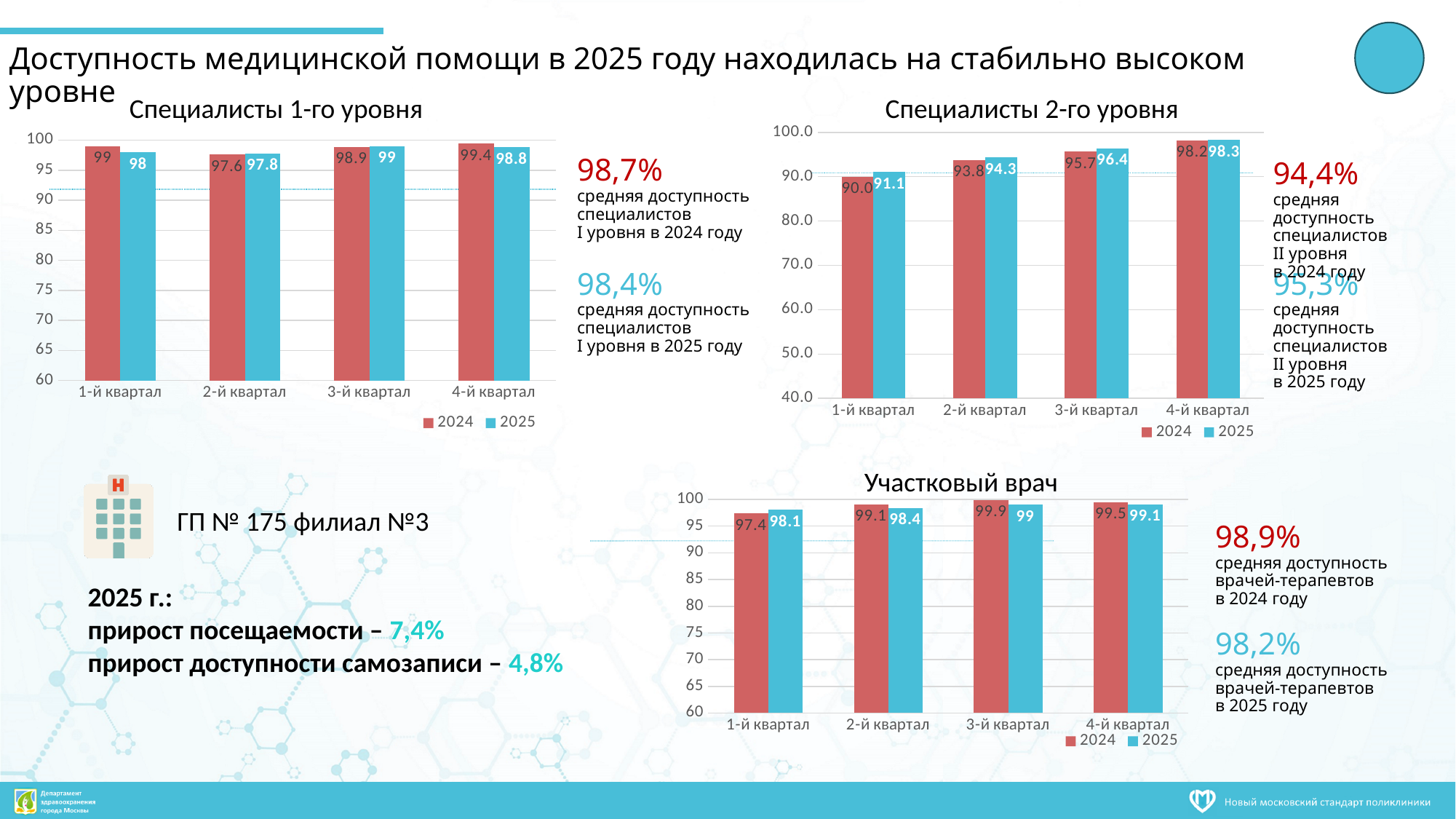
In the chart titled 'Специалисты 1-го уровня', what is the value for 2024 in 2-й квартал? 97.6 What kind of chart is the chart titled 'Специалисты 1-го уровня'? bar chart In the chart titled 'Специалисты 2-го уровня', do the 2024 values rise or fall from 1-й квартал to 4-й квартал? rise In the chart titled 'Специалисты 2-го уровня', which quarter has the lowest value for 2024? 1-й квартал In the chart titled 'Участковый врач', what is the value for 2024 in 3-й квартал? 99.9 In the chart titled 'Участковый врач', which is larger in 1-й квартал: the 2024 value or the 2025 value? 2025 In the chart titled 'Специалисты 1-го уровня', what is the value for 2025 in 4-й квартал? 98.8 In the chart titled 'Специалисты 1-го уровня', which quarter has the highest value for 2024? 4-й квартал How many series does the legend list in the chart titled 'Участковый врач'? 2 In the chart titled 'Участковый врач', what is the difference between the 2024 and 2025 values in 2-й квартал? 0.7 In the chart titled 'Специалисты 2-го уровня', what is the value for 2025 in 1-й квартал? 91.1 In the chart titled 'Специалисты 2-го уровня', what is the difference between the 2025 and 2024 values in 3-й квартал? 0.7